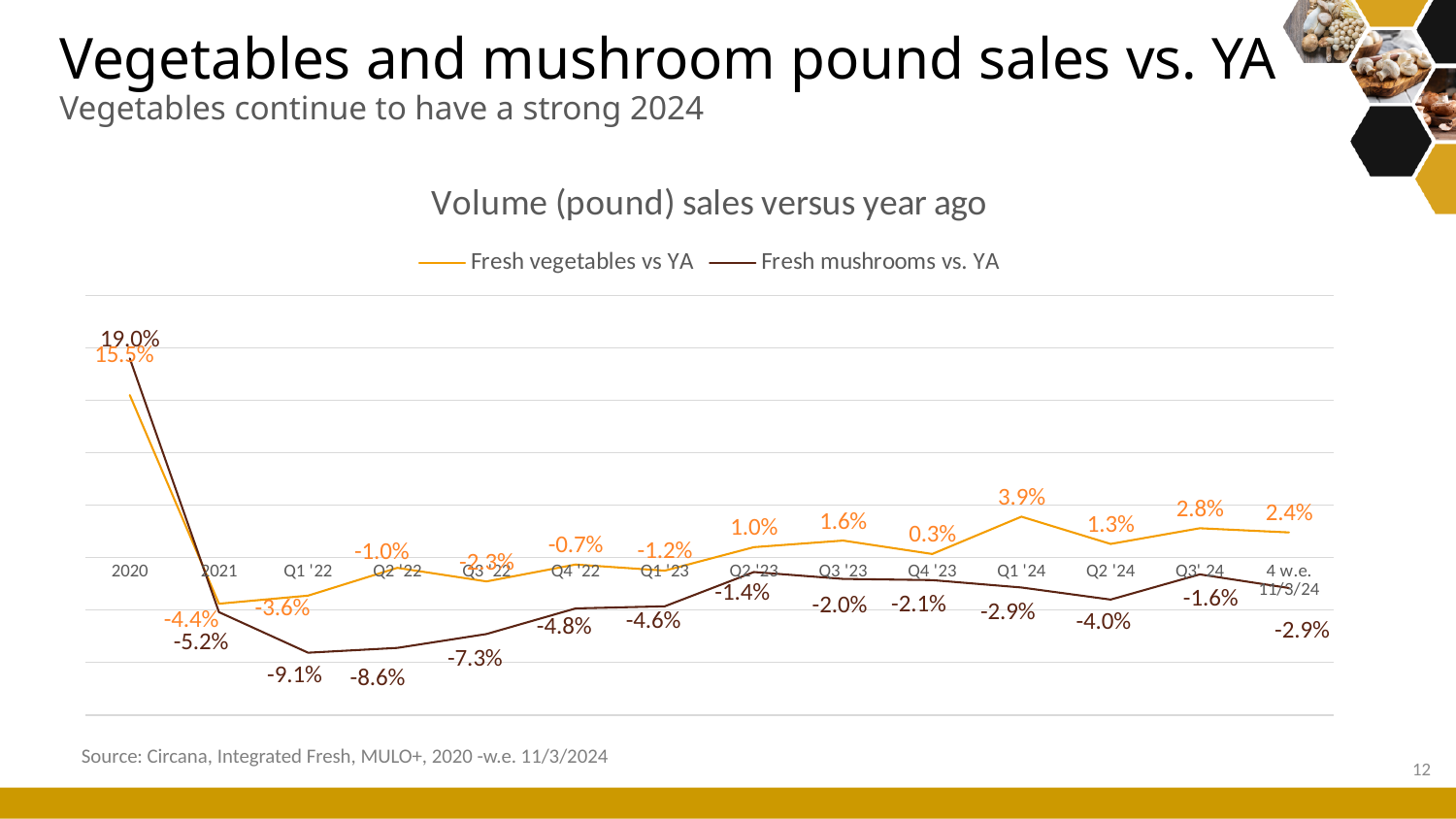
How many series does the legend list? 2 What is the difference between the Fresh vegetables vs YA value and the Fresh mushrooms vs. YA value in Q1 '24? 6.8 percentage points In which period is the Fresh mushrooms vs. YA value highest? 2020 What is the value for Fresh mushrooms vs. YA in Q1 '22? -9.1% In Q2 '24, which series has the larger value, Fresh vegetables vs YA or Fresh mushrooms vs. YA? Fresh vegetables vs YA What kind of chart is shown on the slide? Line chart What is the value for Fresh vegetables vs YA for the 4 w.e. 11/3/24 period? 2.4% In which period is the Fresh mushrooms vs. YA value lowest? Q1 '22 How many periods are plotted along the x axis? 14 What is the value for Fresh vegetables vs YA in Q1 '24? 3.9% What is the value for Fresh mushrooms vs. YA in 2020? 19.0% What is the title of the chart? Volume (pound) sales versus year ago